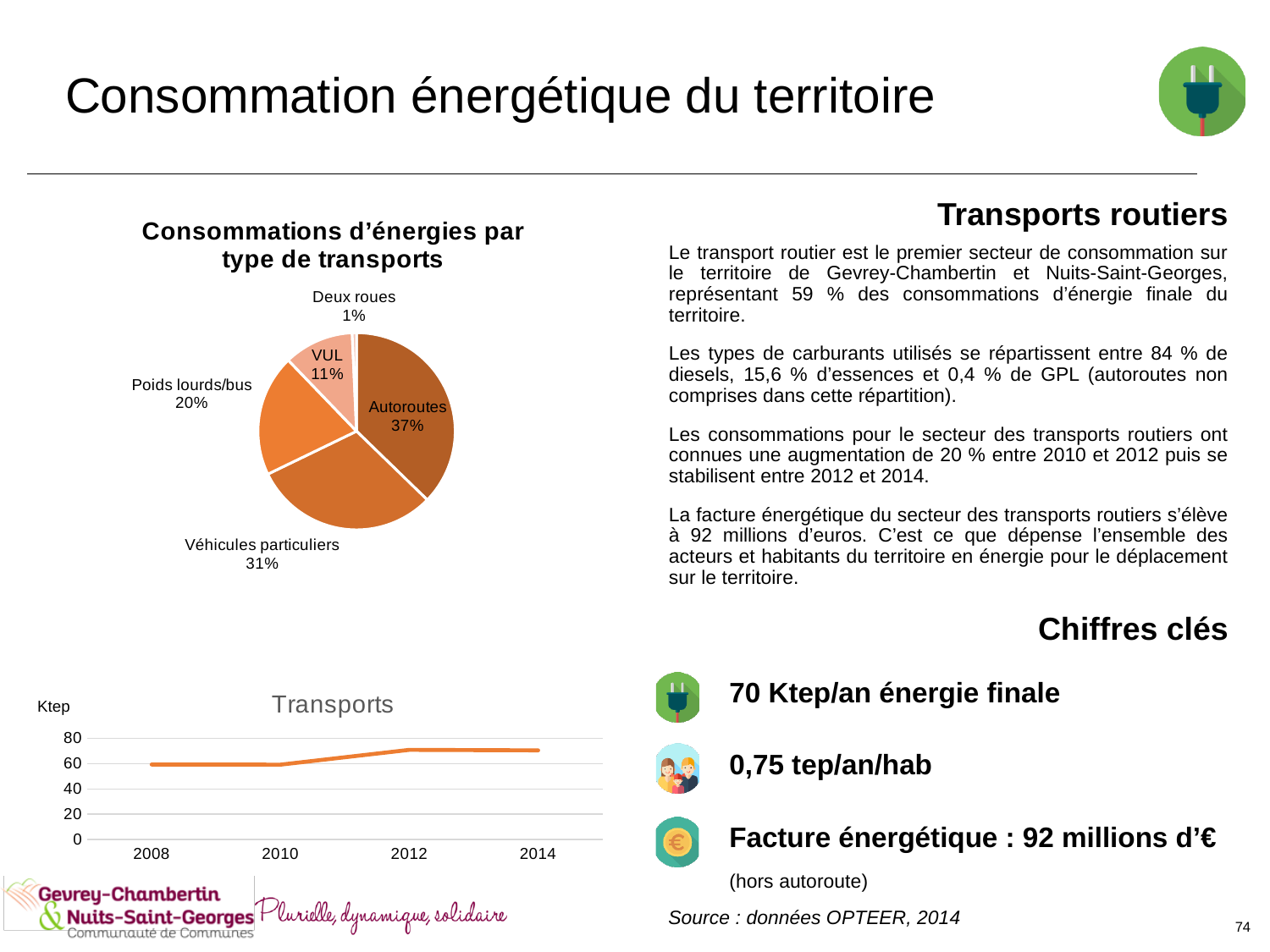
In the 'Transports' line chart, do the values rise or fall from 2010 to 2012? rise In the pie chart 'Consommations d'énergies par type de transports', which is larger: Poids lourds/bus or Véhicules particuliers? Véhicules particuliers In the pie chart 'Consommations d'énergies par type de transports', what share is Autoroutes? 37% What kind of chart is the 'Transports' chart at the bottom left of the slide? Line chart How many categories does the pie chart 'Consommations d'énergies par type de transports' show? 5 In the 'Transports' line chart, is the value for 2008 greater or less than 40? greater In the pie chart 'Consommations d'énergies par type de transports', which category has the smallest share? Deux roues In the pie chart 'Consommations d'énergies par type de transports', what share is Poids lourds/bus? 20% In the pie chart 'Consommations d'énergies par type de transports', which category has the largest share? Autoroutes In the pie chart 'Consommations d'énergies par type de transports', what is the difference in percentage points between Autoroutes and VUL? 26 In the pie chart 'Consommations d'énergies par type de transports', what share is Véhicules particuliers? 31% In the 'Transports' line chart, is the value for 2014 greater or less than 80? less